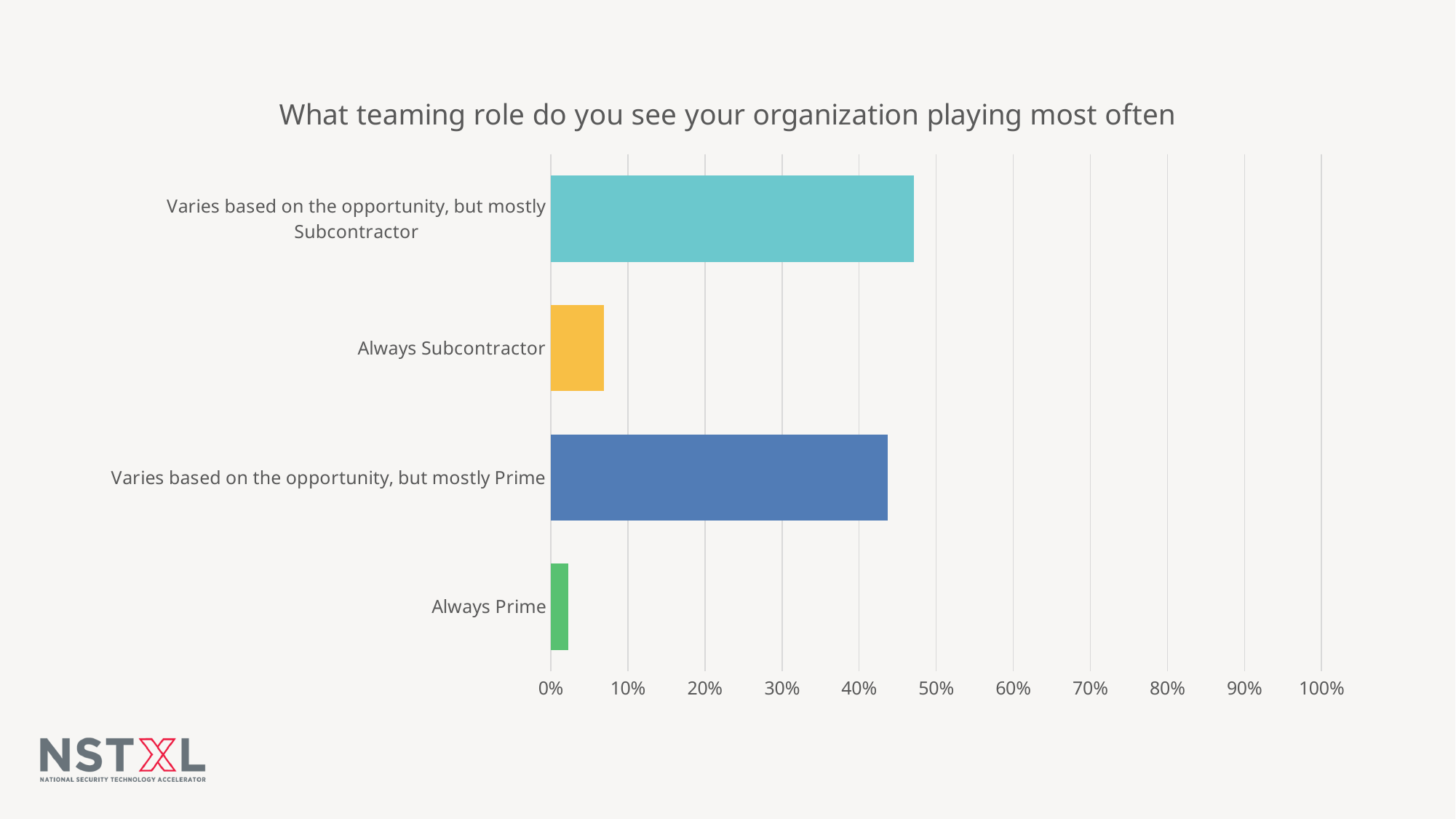
Which is larger: the value for Varies based on the opportunity, but mostly Subcontractor or the value for Varies based on the opportunity, but mostly Prime? Varies based on the opportunity, but mostly Subcontractor Is the value for Always Subcontractor greater or less than 10%? less Is the value for Varies based on the opportunity, but mostly Subcontractor greater or less than 50%? less Which is larger: the value for Always Subcontractor or the value for Always Prime? Always Subcontractor Which category has the highest value? Varies based on the opportunity, but mostly Subcontractor What is the title of the chart? What teaming role do you see your organization playing most often What colour is the bar for Always Subcontractor? yellow Is the value for Always Prime greater or less than 10%? less Which category has the lowest value? Always Prime How many categories are plotted in the chart? 4 What kind of chart is shown on the slide? bar chart